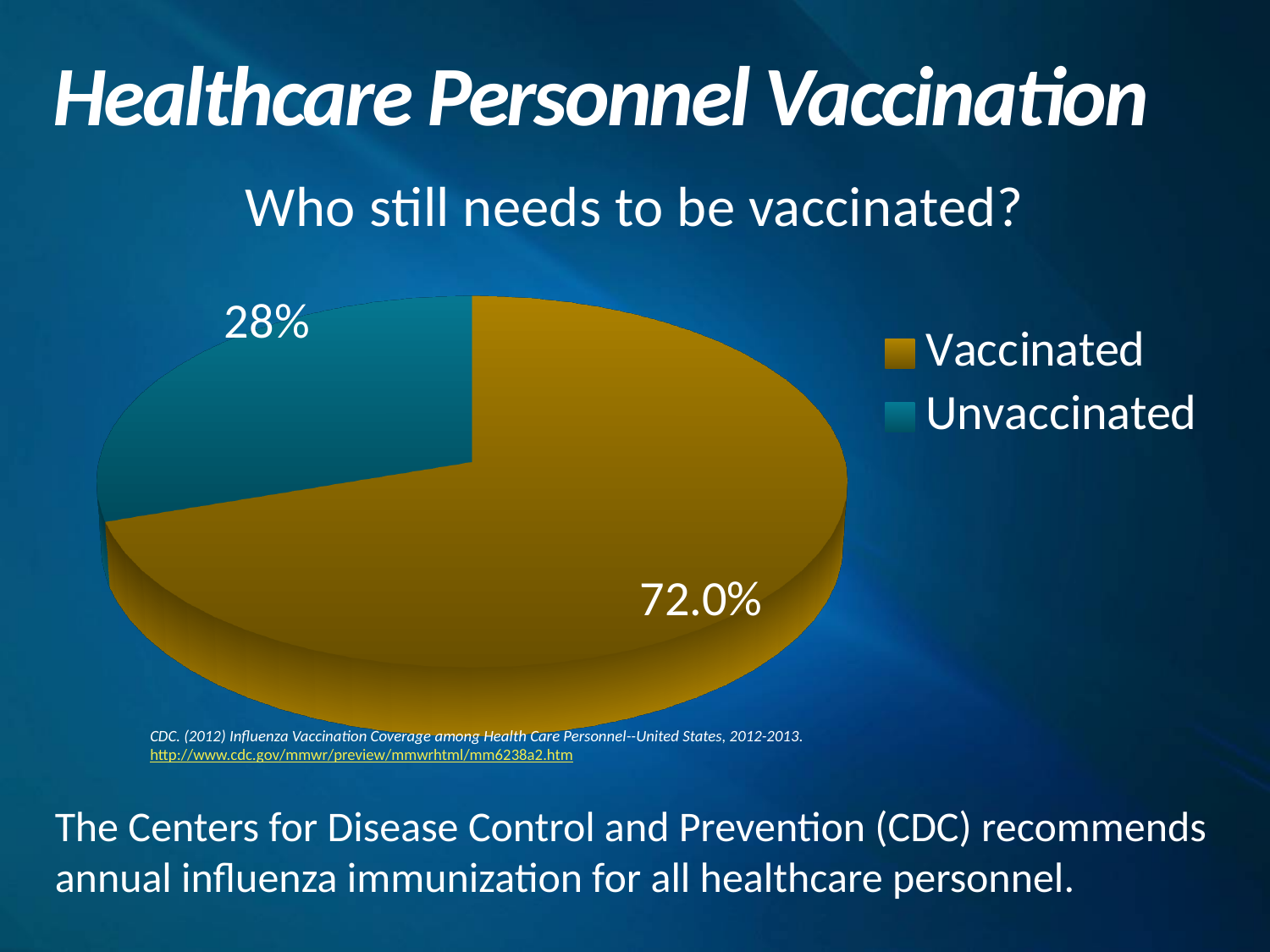
Which slice of the pie is the smallest? Unvaccinated What is the difference in percentage points between the Vaccinated and Unvaccinated slices? 44 Which slice of the pie is the largest? Vaccinated What share of the pie does the Unvaccinated slice represent? 28% What kind of chart is shown on the slide? pie chart How many slices does the pie chart have? 2 How many entries does the legend list? 2 Which is larger, the Vaccinated slice or the Unvaccinated slice? Vaccinated What colour is the Vaccinated slice in the pie chart? gold What percentage of healthcare personnel are shown as Vaccinated? 72.0% What percentage of healthcare personnel are shown as Unvaccinated? 28% What question is posed as the chart's heading above the pie? Who still needs to be vaccinated?